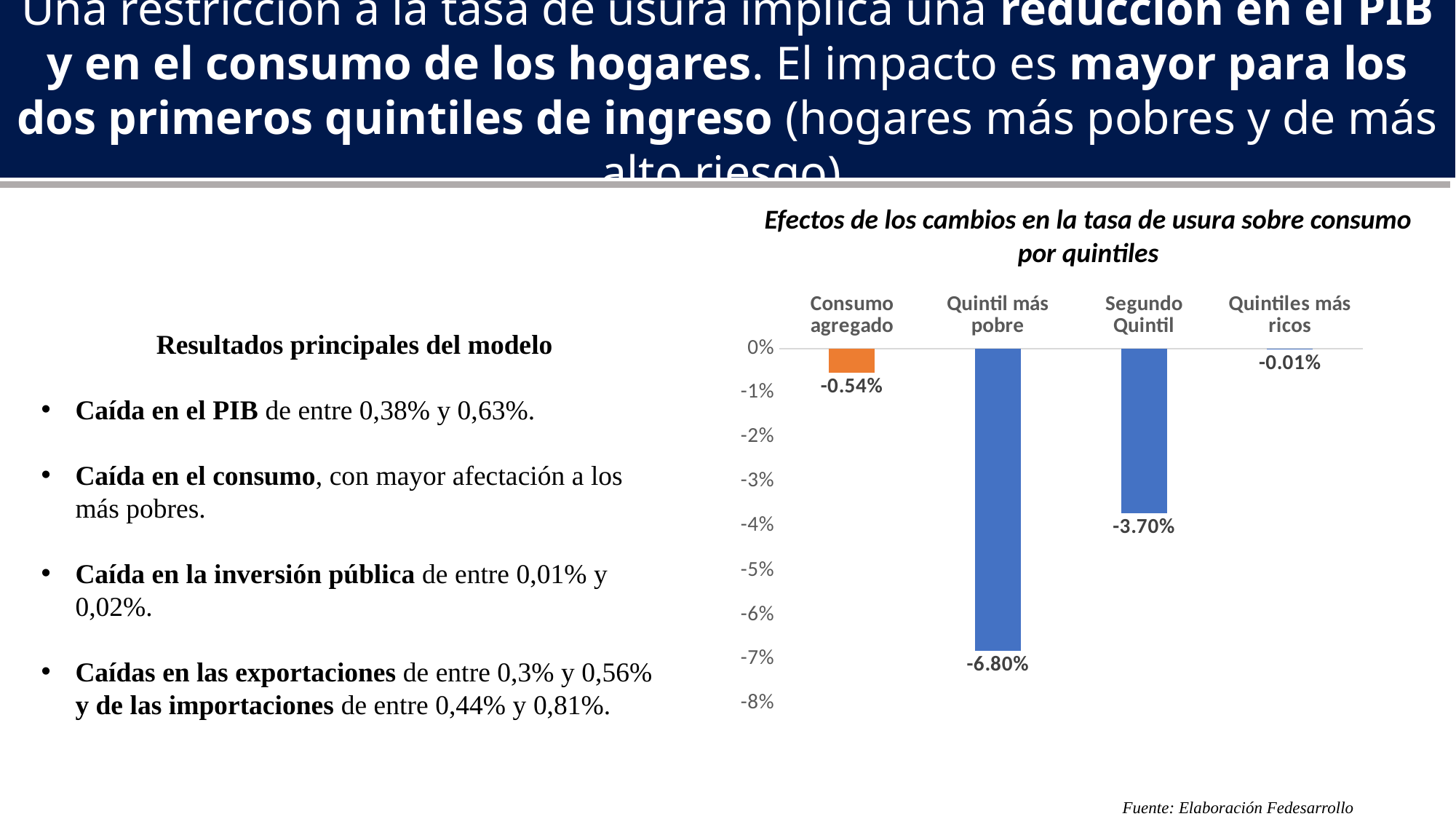
Is the value for Quintil más pobre greater or less than -5%? less Which is larger in magnitude, the decline for Segundo Quintil or for Consumo agregado? Segundo Quintil What is the value for Quintiles más ricos? -0.01% How many categories are shown in the chart? 4 What kind of chart is shown on the slide? Bar chart Which category has the highest (least negative) value? Quintiles más ricos What is the value for Quintil más pobre? -6.80% What is the value for Consumo agregado? -0.54% What is the value for Segundo Quintil? -3.70% What is the difference between the values for Quintil más pobre and Segundo Quintil? 3.10% What is the title of the chart? Efectos de los cambios en la tasa de usura sobre consumo por quintiles Which category has the lowest (most negative) value? Quintil más pobre